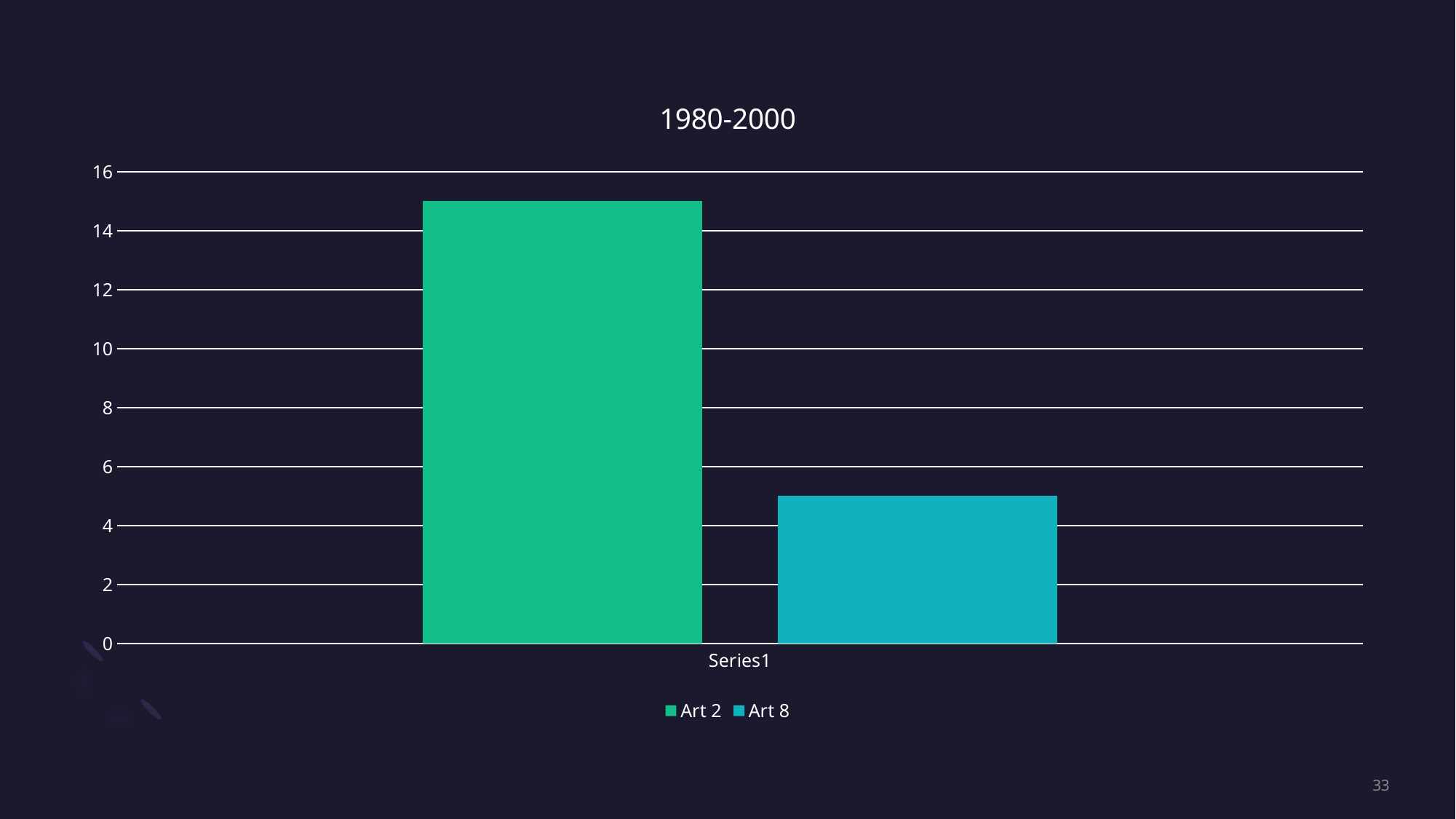
How many categories are shown on the x axis? 1 Is the value for Art 2 greater or less than 16? less Is the value for Art 2 greater or less than 14? greater Is the value for Art 8 greater or less than 4? greater Which series has the highest value? Art 2 What is the label of the category on the x axis? Series1 Which series has the lowest value? Art 8 Which series has the taller bar, Art 2 or Art 8? Art 2 How many series does the legend list? 2 What is the title of the chart? 1980-2000 What kind of chart is shown on the slide? bar chart